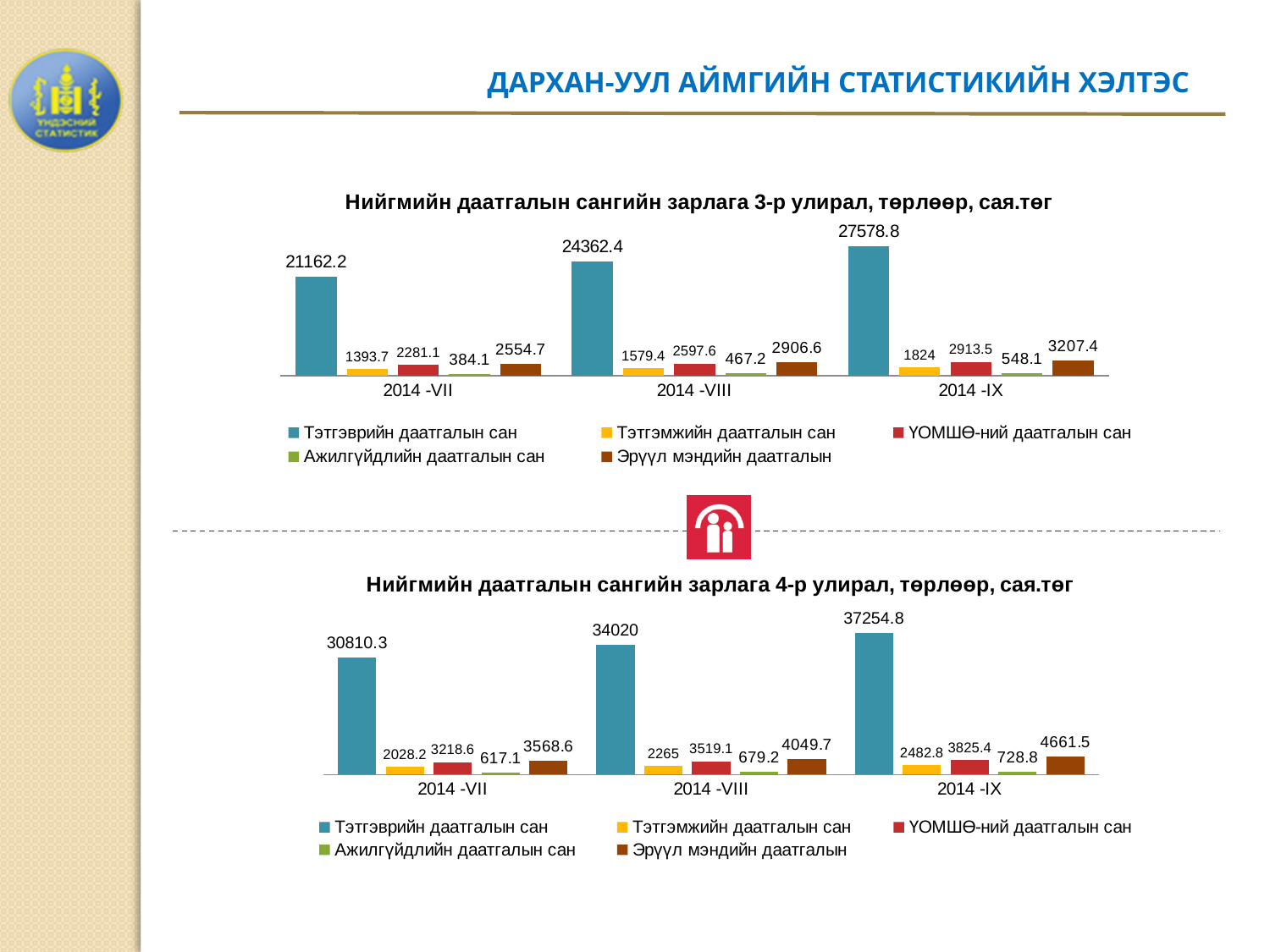
In the bottom chart (4-р улирал), do the Тэтгэврийн даатгалын сан values rise or fall from 2014 -VII to 2014 -IX? Rise In the top chart (3-р улирал), what is the value of Ажилгүйдлийн даатгалын сан for 2014 -VII? 384.1 What kind of chart is the top chart (3-р улирал)? Bar chart In the top chart (3-р улирал), which series has the highest value in every period? Тэтгэврийн даатгалын сан In the bottom chart (4-р улирал), what is the value of Тэтгэмжийн даатгалын сан for 2014 -VIII? 2265 In the top chart (3-р улирал), what is the value of Тэтгэврийн даатгалын сан for 2014 -VIII? 24362.4 In the bottom chart (4-р улирал), which is larger: ҮОМШӨ-ний даатгалын сан for 2014 -VII or Эрүүл мэндийн даатгалын for 2014 -VII? Эрүүл мэндийн даатгалын In the top chart (3-р улирал), what is the difference between the Тэтгэврийн даатгалын сан values for 2014 -IX and 2014 -VII? 6416.6 How many periods are shown on the x axis of the top chart (3-р улирал)? 3 In the bottom chart (4-р улирал), which series has the lowest value for 2014 -IX? Ажилгүйдлийн даатгалын сан How many series does the legend of the bottom chart (4-р улирал) list? 5 In the bottom chart (4-р улирал), what is the value of Эрүүл мэндийн даатгалын for 2014 -IX? 4661.5